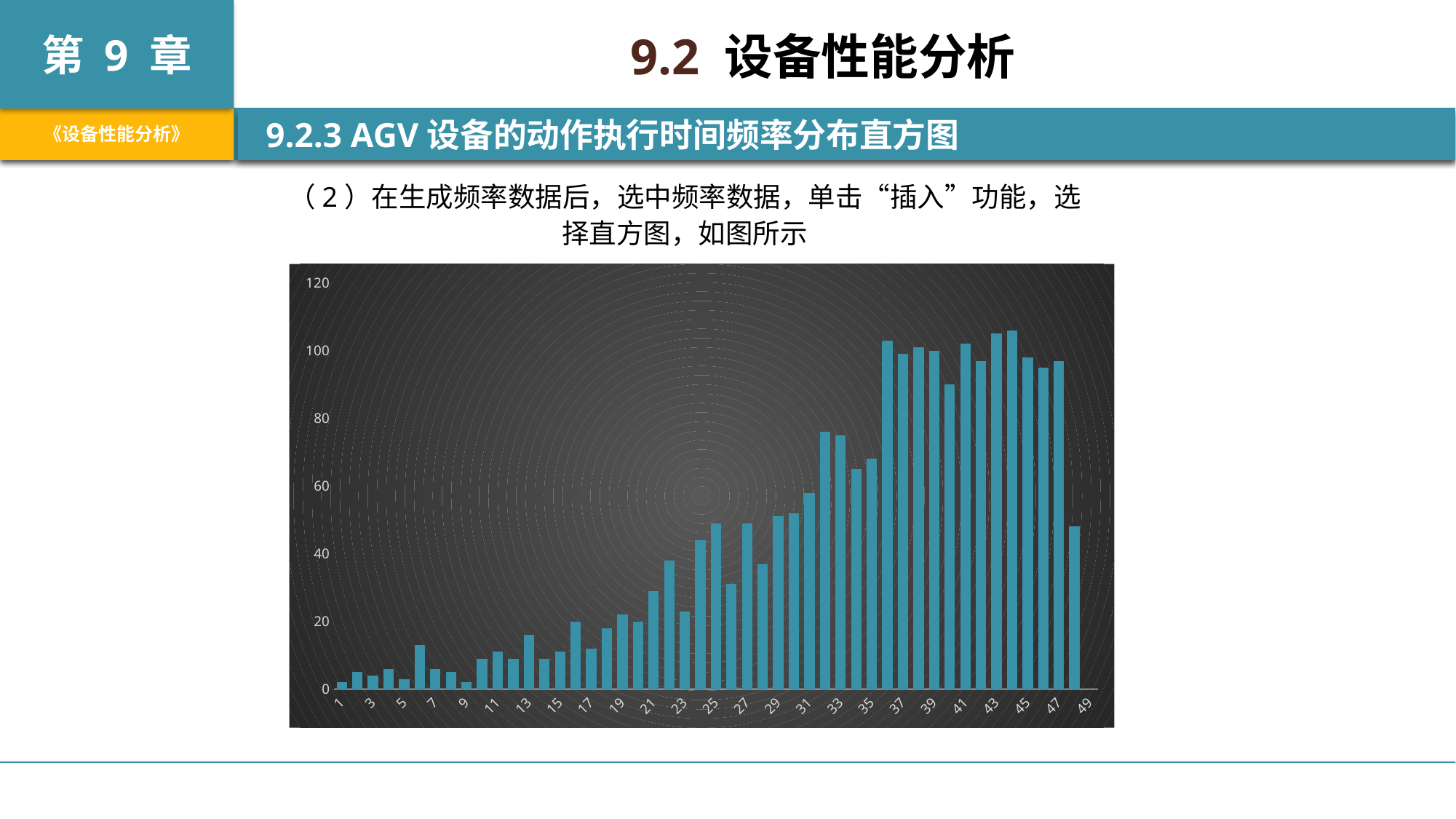
Is the value for category 1 greater or less than 20? less Is the value for category 13 greater or less than 20? less Is the value for category 44 greater or less than 100? greater Do the values generally rise or fall along the x axis from category 1 to category 37? rise What colour are the bars in the chart? blue What is the highest tick value shown on the vertical axis? 120 What kind of chart is shown on the slide? bar chart